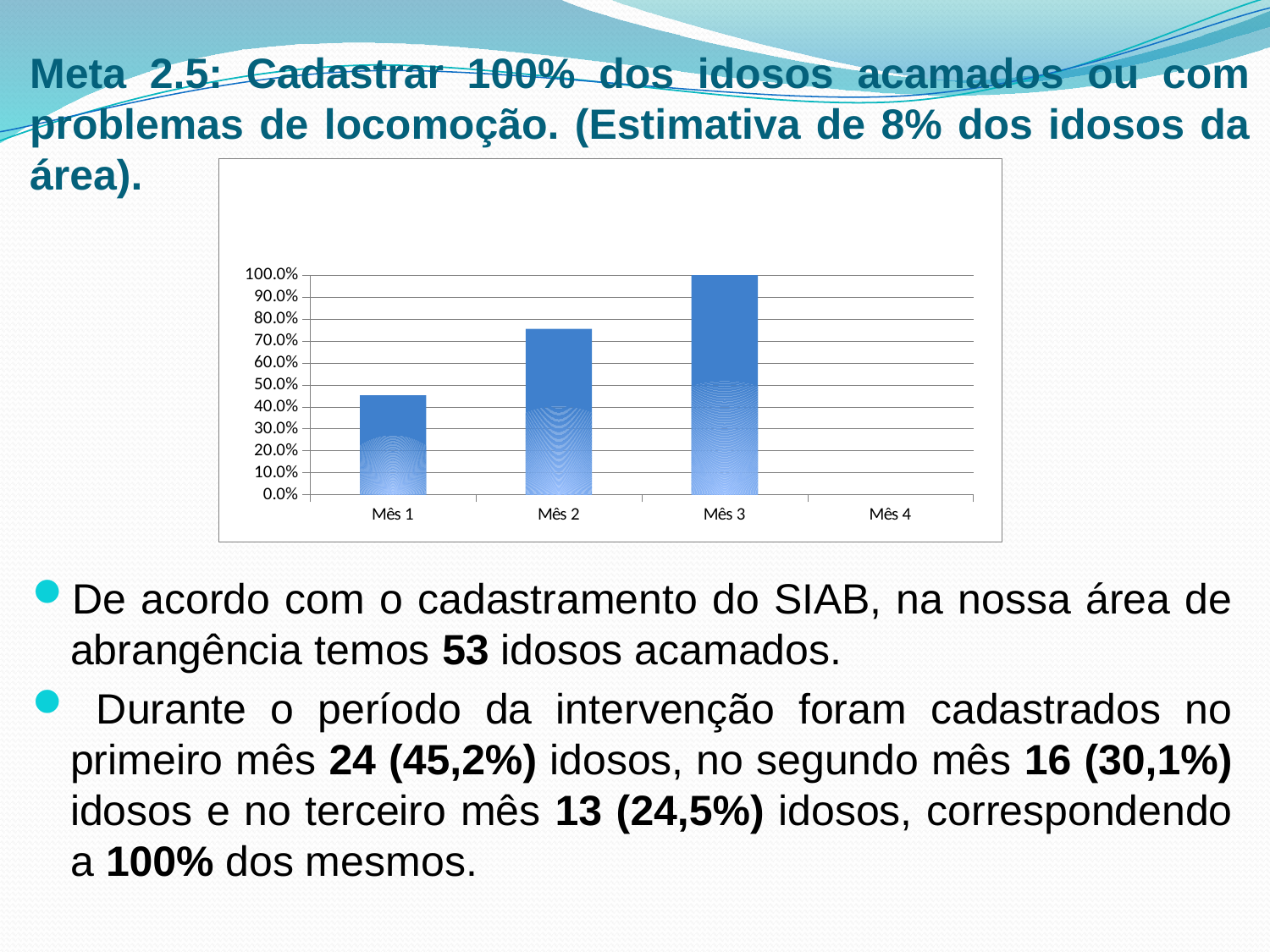
Do the bar values rise or fall from Mês 1 to Mês 3? rise What is the highest tick label shown on the y axis of the chart? 100.0% Which is larger, the bar for Mês 1 or the bar for Mês 2? Mês 2 What kind of chart is shown on the slide? bar chart Is the value for Mês 2 greater or less than 70.0%? greater Is the value for Mês 1 greater or less than 40.0%? greater What is the value of the bar for Mês 3? 100.0% Is the value for Mês 1 greater or less than 50.0%? less Among Mês 1, Mês 2 and Mês 3, which month has the lowest bar? Mês 1 How many categories are shown on the x axis of the chart? 4 Which month has the highest bar in the chart? Mês 3